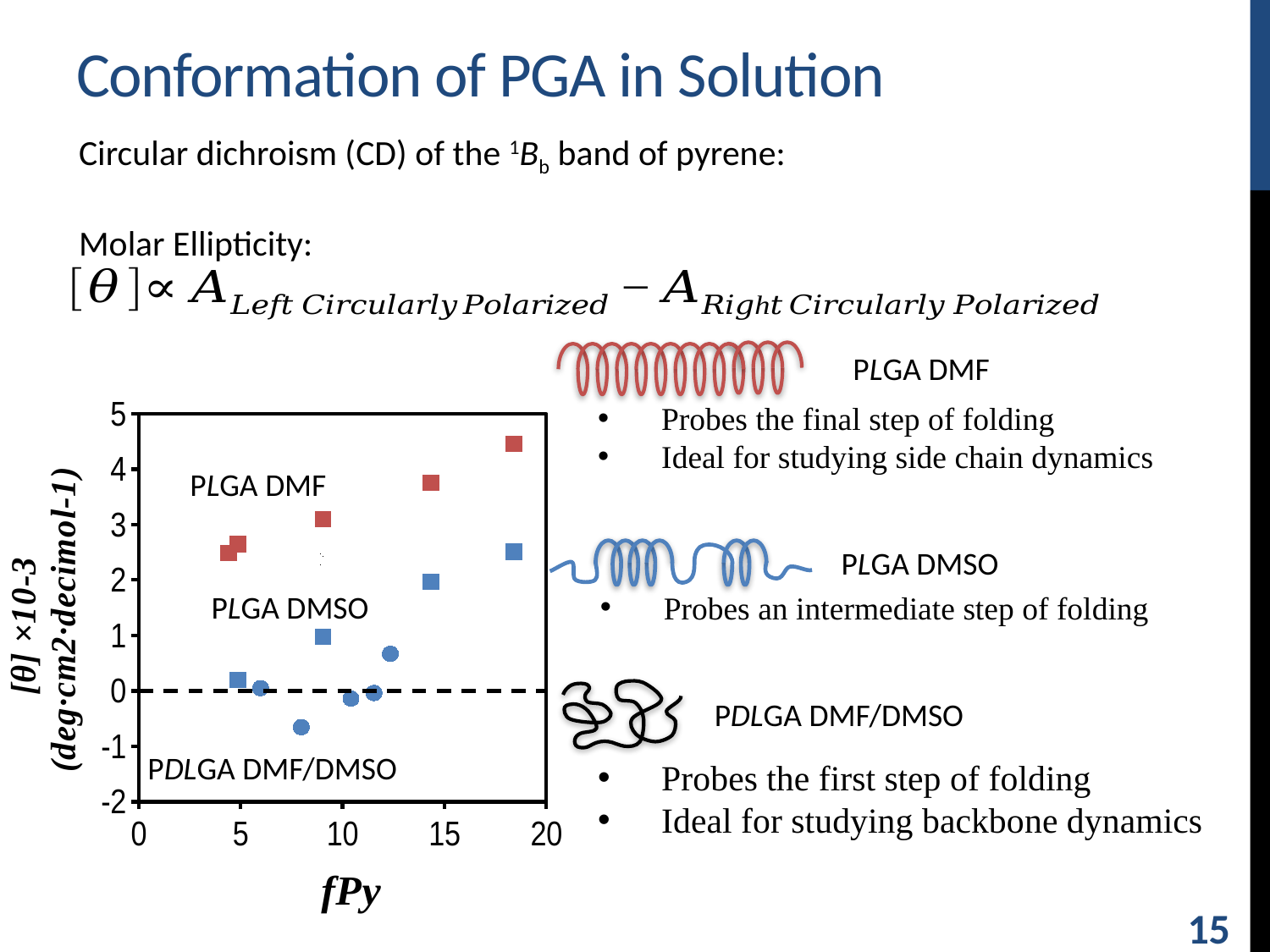
Is the value for the PLGA DMSO point at the highest fPy greater or less than 2? greater At the highest fPy value, which series has the larger molar ellipticity, PLGA DMF or PLGA DMSO? PLGA DMF How many data series are labelled inside the chart? 3 Which series contains the lowest point in the chart? PDLGA DMF/DMSO What is the label of the x axis of the chart? fPy How many PLGA DMF (red square) points are plotted in the chart? 5 What kind of chart is shown on the slide? scatter chart Do the PLGA DMF values rise or fall as fPy increases? rise Which series has the highest molar ellipticity values in the chart? PLGA DMF Is the value for the PLGA DMF point at the highest fPy greater or less than 4? greater Is the value for the PLGA DMF point near fPy 9 greater or less than 2? greater